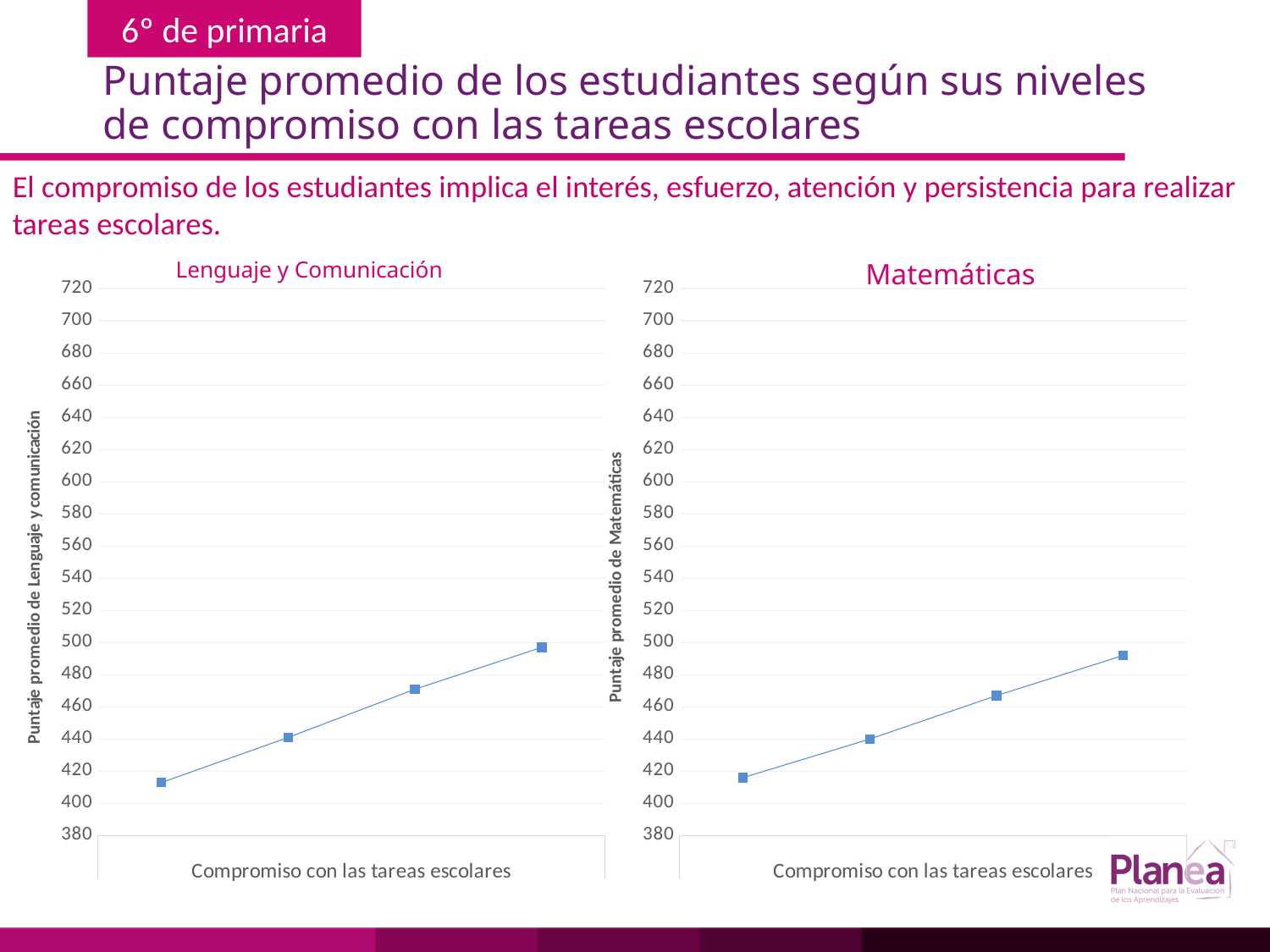
How many data points are plotted on the Matemáticas chart? 4 On the Matemáticas chart, is the value of the leftmost point greater or less than 440? less On the Matemáticas chart, is the value of the rightmost point greater or less than 480? greater What kind of chart is the Matemáticas chart? line chart What is the x-axis title of the Lenguaje y Comunicación chart? Compromiso con las tareas escolares How many data points are plotted on the Lenguaje y Comunicación chart? 4 What kind of chart is the Lenguaje y Comunicación chart? line chart On the Lenguaje y Comunicación chart, is the value of the rightmost point greater or less than 480? greater On the Matemáticas chart, do the values rise or fall from left to right along the x axis? rise On the Matemáticas chart, which is larger: the value of the leftmost point or the value of the rightmost point? the rightmost point On the Lenguaje y Comunicación chart, do the values rise or fall from left to right along the x axis? rise